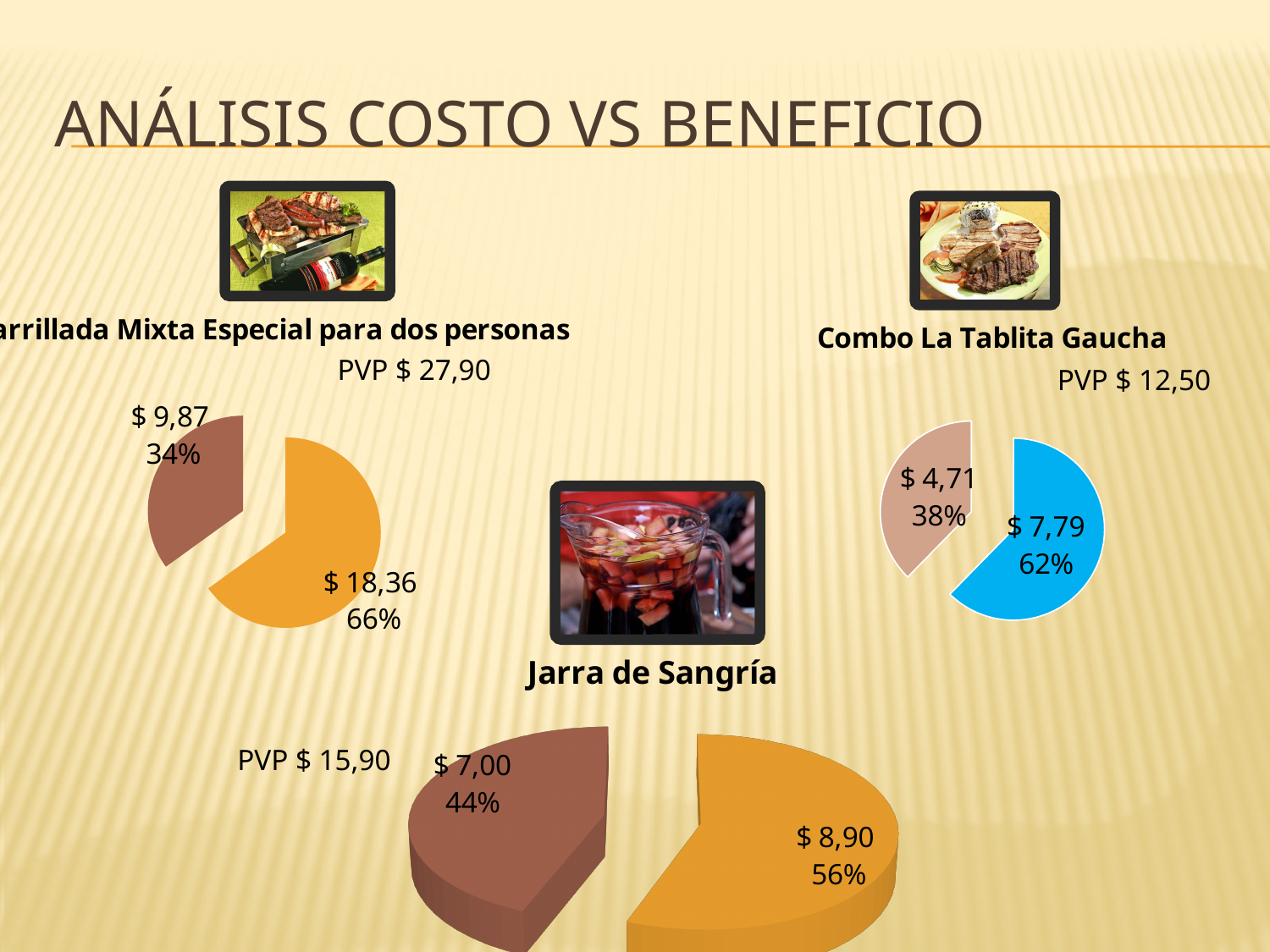
In the Jarra de Sangría pie chart, which slice is larger, the $ 7,00 slice or the $ 8,90 slice? $ 8,90 What kind of chart is used for the Parrillada Mixta Especial para dos personas item? pie chart In the Combo La Tablita Gaucha pie chart, what share does the $ 4,71 slice represent? 38% In the Jarra de Sangría pie chart, what value is shown on the brown slice? $ 7,00 In the Parrillada Mixta Especial pie chart, what percentage is shown on the brown slice? 34% In the Jarra de Sangría pie chart, what percentage is shown on the orange slice? 56% In the Parrillada Mixta Especial pie chart, what value is shown on the larger (orange) slice? $ 18,36 What PVP is shown for the Jarra de Sangría? $ 15,90 How many pie charts are shown on the slide? 3 In the Combo La Tablita Gaucha pie chart, what value is shown on the blue slice? $ 7,79 In the Combo La Tablita Gaucha pie chart, what is the difference between the $ 7,79 slice and the $ 4,71 slice? $ 3,08 How many slices does the Parrillada Mixta Especial pie chart have? 2